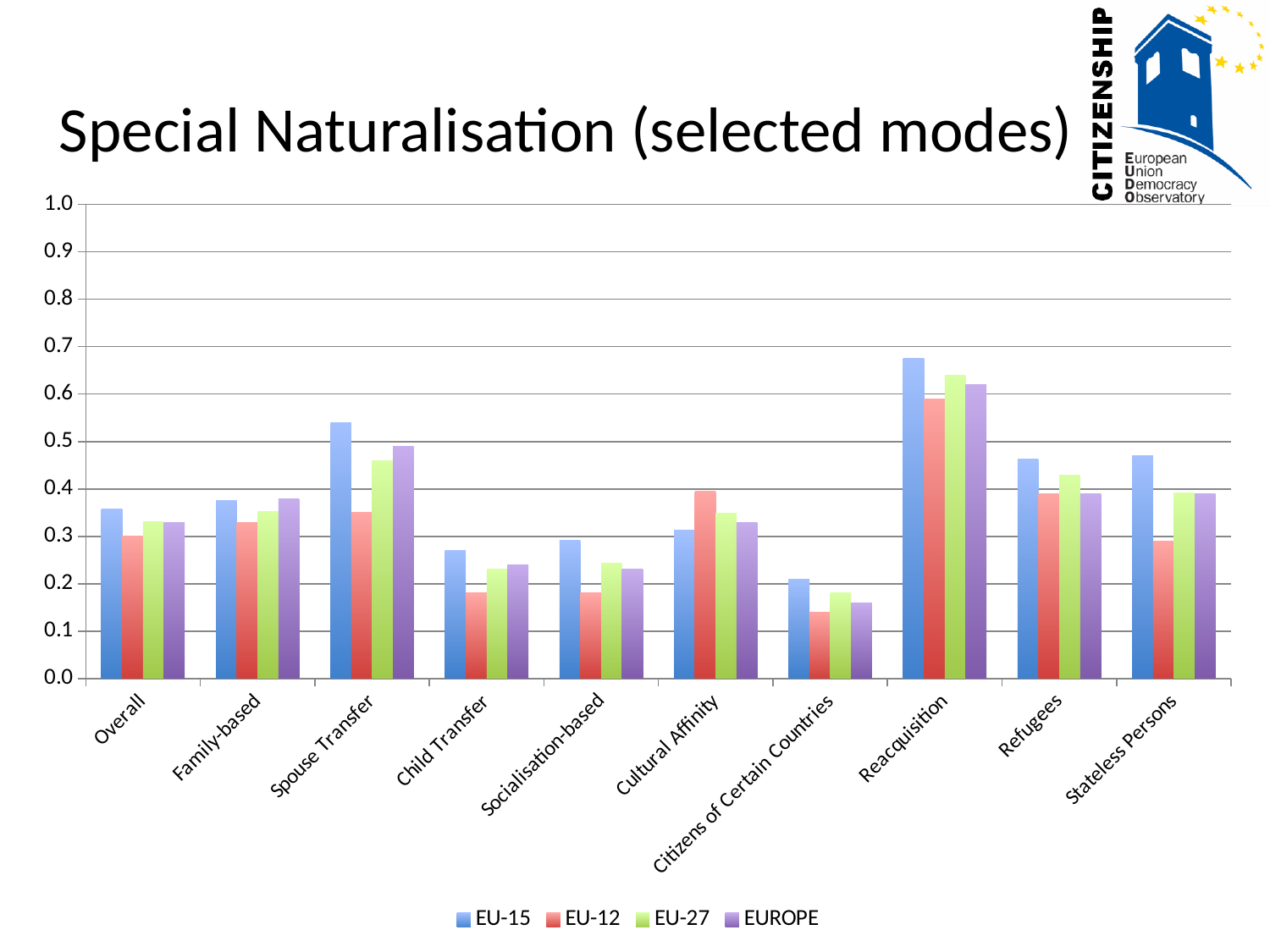
How many categories are shown on the x axis? 10 For Cultural Affinity, which is larger: the EU-15 value or the EU-12 value? EU-12 What kind of chart is shown on the slide? bar chart Is the EU-12 value for Citizens of Certain Countries greater or less than 0.2? less What colour represents the EU-27 series in the legend? green How many series does the legend list? 4 Is the EU-15 value for Spouse Transfer greater or less than 0.5? greater Is the EU-12 value for Child Transfer greater or less than 0.2? less Which category has the highest EU-15 value? Reacquisition Which category has the lowest EUROPE value? Citizens of Certain Countries For Stateless Persons, which is larger: the EU-15 value or the EU-12 value? EU-15